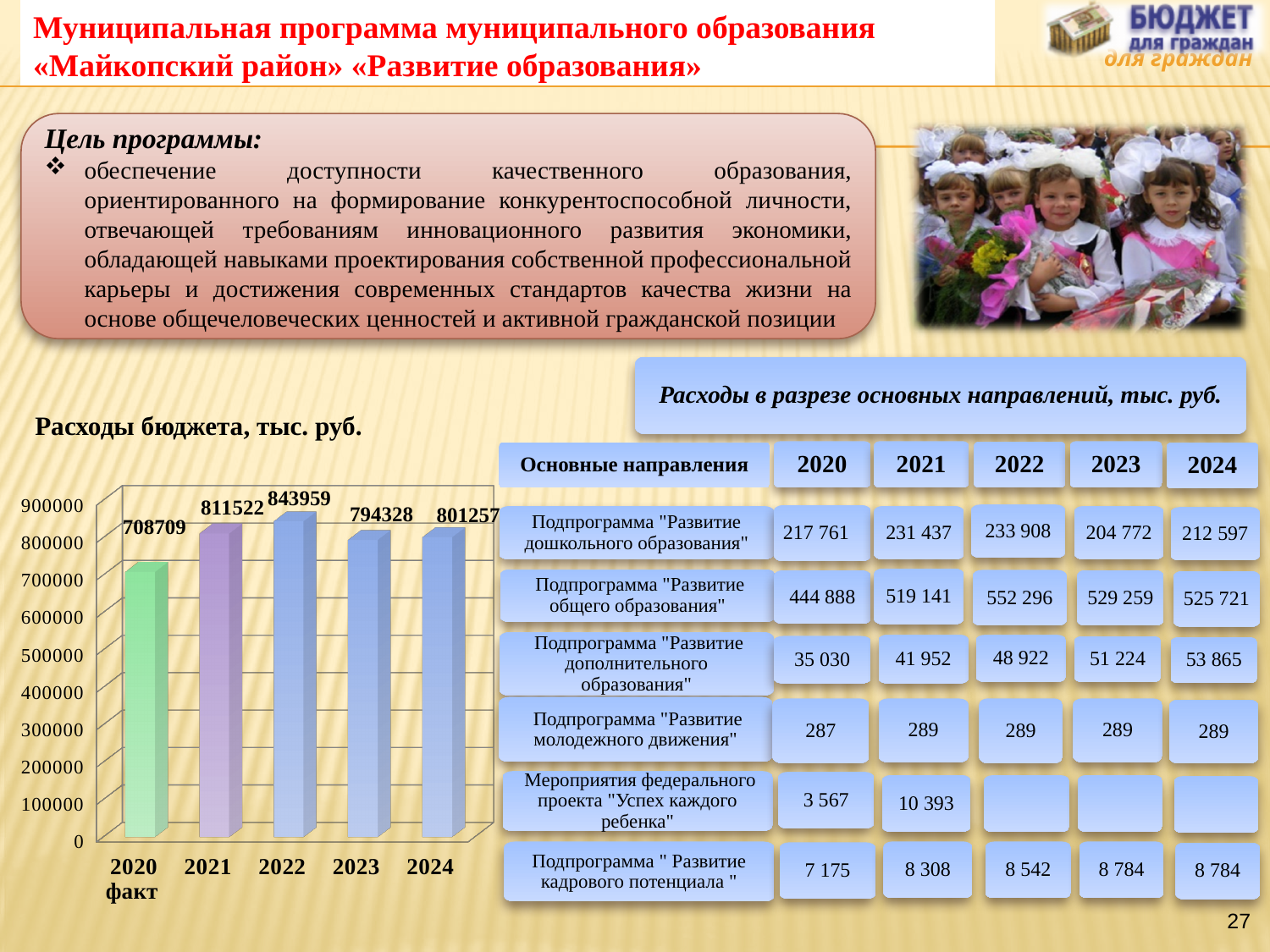
In the chart "Расходы бюджета, тыс. руб.", which is larger: the value for 2023 or the value for 2024? 2024 Which year has the lowest value in the chart "Расходы бюджета, тыс. руб."? 2020 факт What is the value for 2024 in the chart "Расходы бюджета, тыс. руб."? 801257 In the chart "Расходы бюджета, тыс. руб.", what is the difference between the values for 2022 and 2021? 32437 What type of chart is shown on the slide under the heading "Расходы бюджета, тыс. руб."? bar chart Which year has the highest value in the chart "Расходы бюджета, тыс. руб."? 2022 What is the value for 2020 факт in the chart "Расходы бюджета, тыс. руб."? 708709 In the chart "Расходы бюджета, тыс. руб.", what is the difference between the values for 2021 and 2020 факт? 102813 How many years (categories) are shown in the chart "Расходы бюджета, тыс. руб."? 5 In the chart "Расходы бюджета, тыс. руб.", is the value for 2020 факт greater or less than 800000? less In the chart "Расходы бюджета, тыс. руб.", does the value rise or fall from 2022 to 2023? fall What is the value for 2022 in the chart "Расходы бюджета, тыс. руб."? 843959